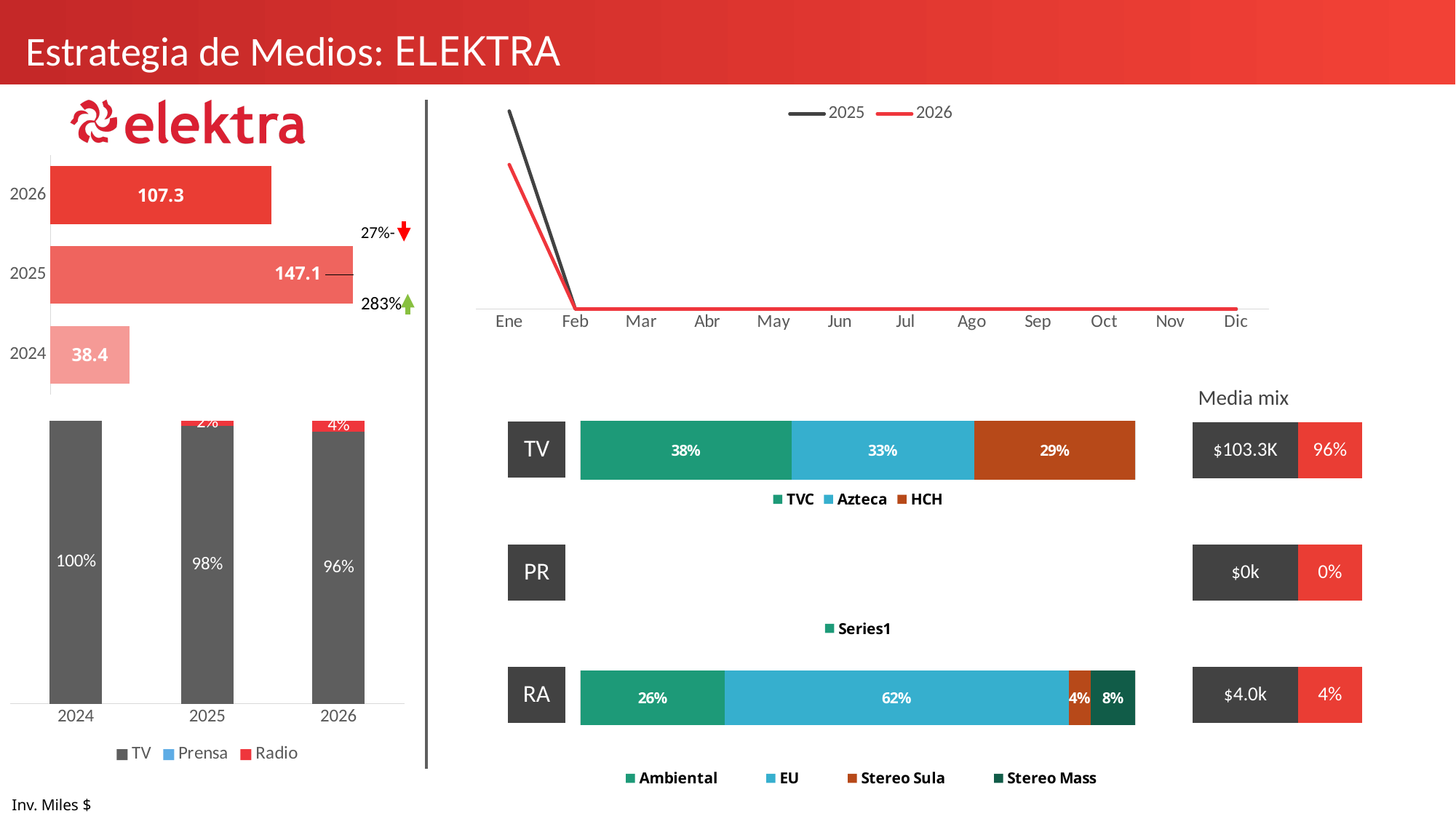
In the TV stacked bar on the right, what is the share for Azteca? 33% In the stacked bar chart at the bottom left, what share does TV have in 2026? 96% In the horizontal bar chart at the top left, which year has the highest value? 2025 How many series does the legend of the stacked bar chart at the bottom left list? 3 In the RA stacked bar on the right, which station has the largest share? EU In the horizontal bar chart at the top left, what is the value for 2025? 147.1 In the stacked bar chart at the bottom left, what share does Radio have in 2025? 2% In the horizontal bar chart at the top left, what is the difference between the 2025 and 2026 values? 39.8 In the horizontal bar chart at the top left, what is the value for 2024? 38.4 In the horizontal bar chart at the top left, which year has the lowest value? 2024 In the line chart at the top right, how many months are shown on the x axis? 12 In the RA stacked bar on the right, what is the difference between the EU and Ambiental shares? 36%